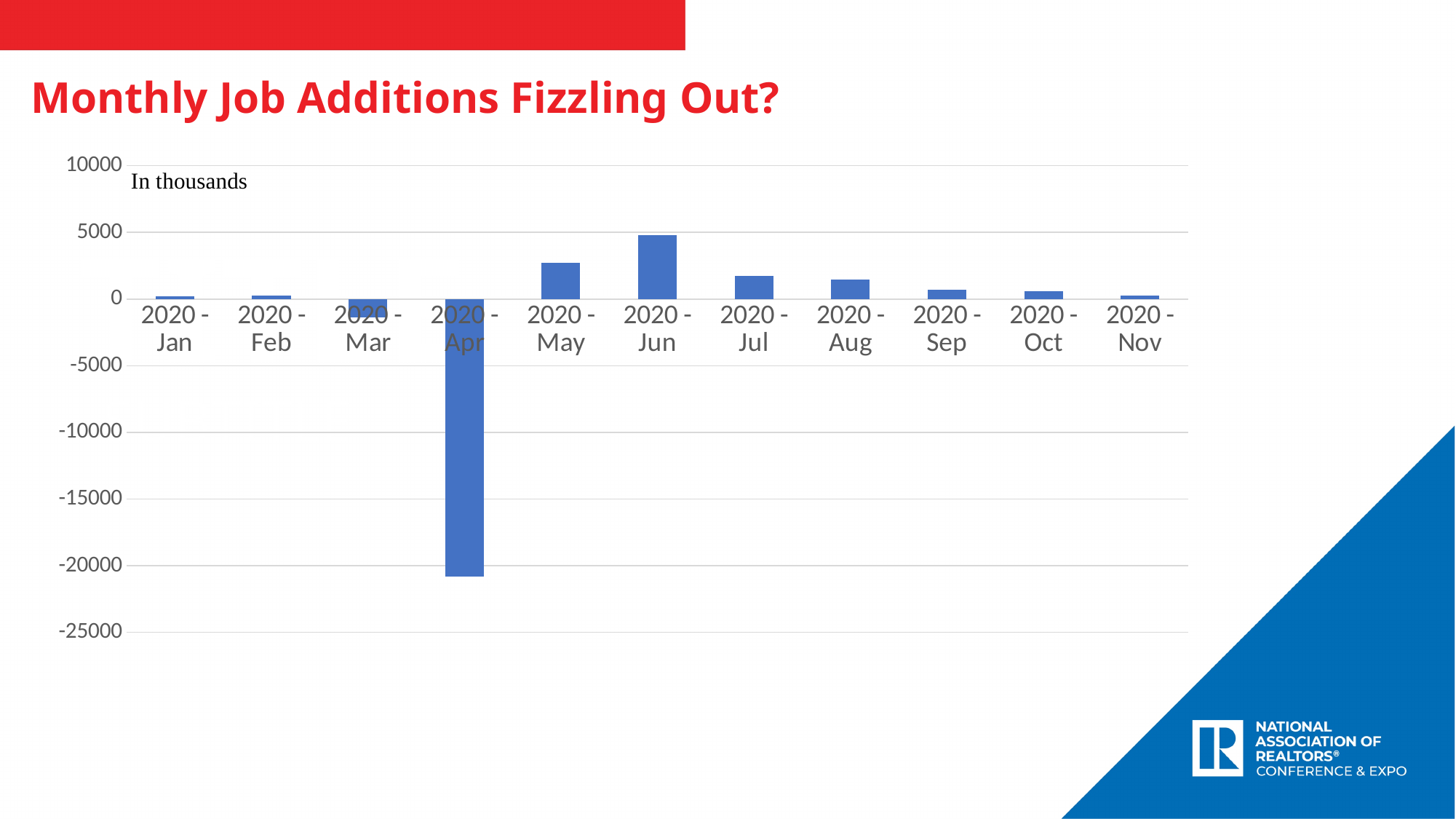
Which month has the highest value on the chart? 2020 - Jun Which is larger, the value for 2020 - Jul or the value for 2020 - Sep? 2020 - Jul Which is larger, the value for 2020 - Jun or the value for 2020 - May? 2020 - Jun What kind of chart is shown on the slide? bar chart Is the value for 2020 - May greater or less than 0? greater How many months are plotted on the chart? 11 Which month has the lowest value on the chart? 2020 - Apr What is the title of the slide? Monthly Job Additions Fizzling Out? Is the value for 2020 - Apr greater or less than -20000? less Is the value for 2020 - Mar greater or less than 0? less Do the values rise or fall from 2020 - Jun to 2020 - Nov? fall